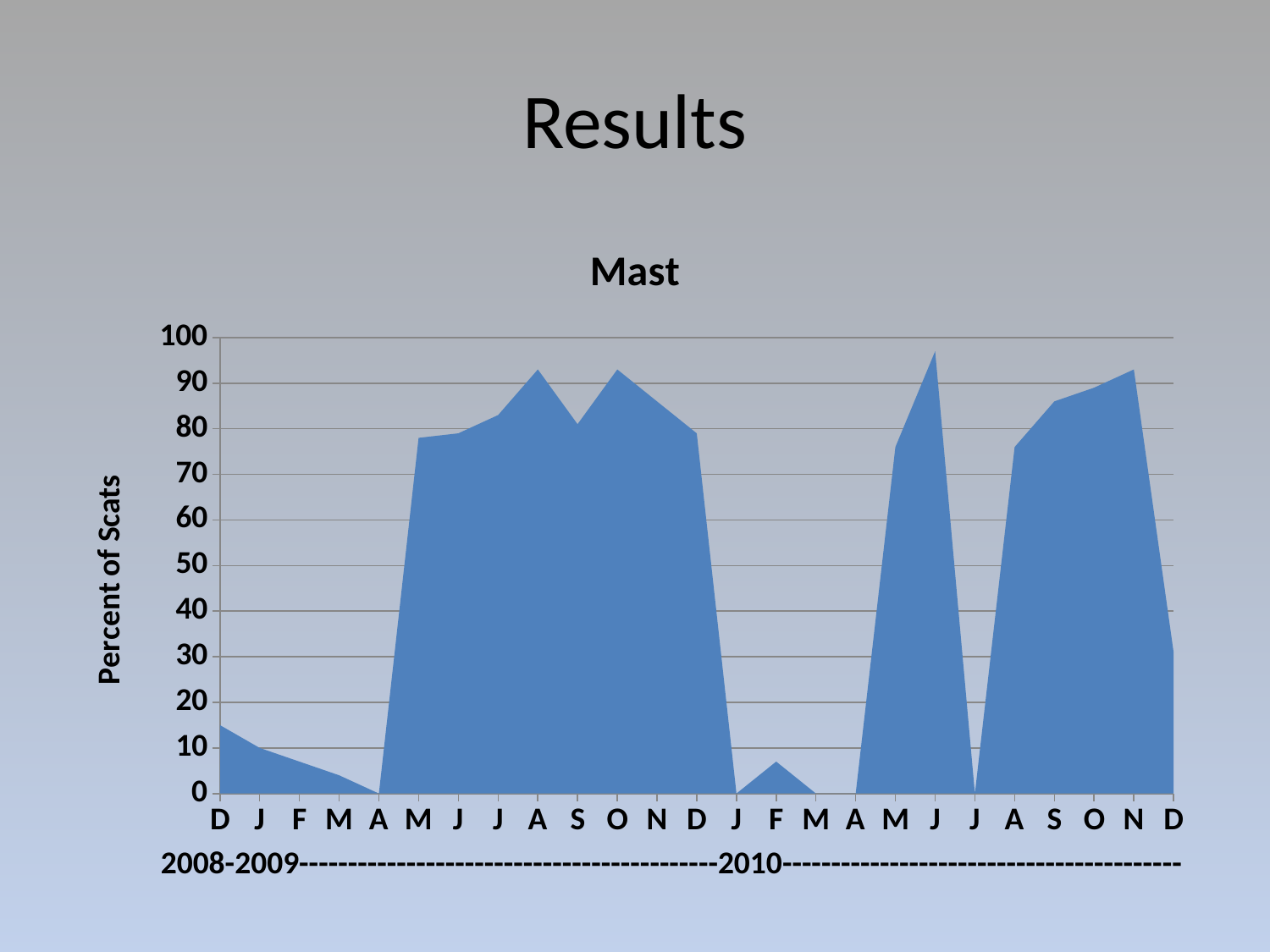
What is the value for April 2009 (the first A on the x axis)? 0 What is the title of the chart? Mast What kind of chart is shown on the slide? area chart Is the value for June 2010 (the peak in 2010) greater or less than 90? greater What is the label on the vertical axis of the chart? Percent of Scats Is the value for August 2009 (the first A after the summer months) greater or less than 90? greater Is the value for February 2010 greater or less than 10? less How many monthly points are plotted along the x axis of the chart? 25 What is the value for January 2010 (the second J on the x axis, at the start of 2010)? 0 Do the values rise or fall from December 2008 to April 2009? fall